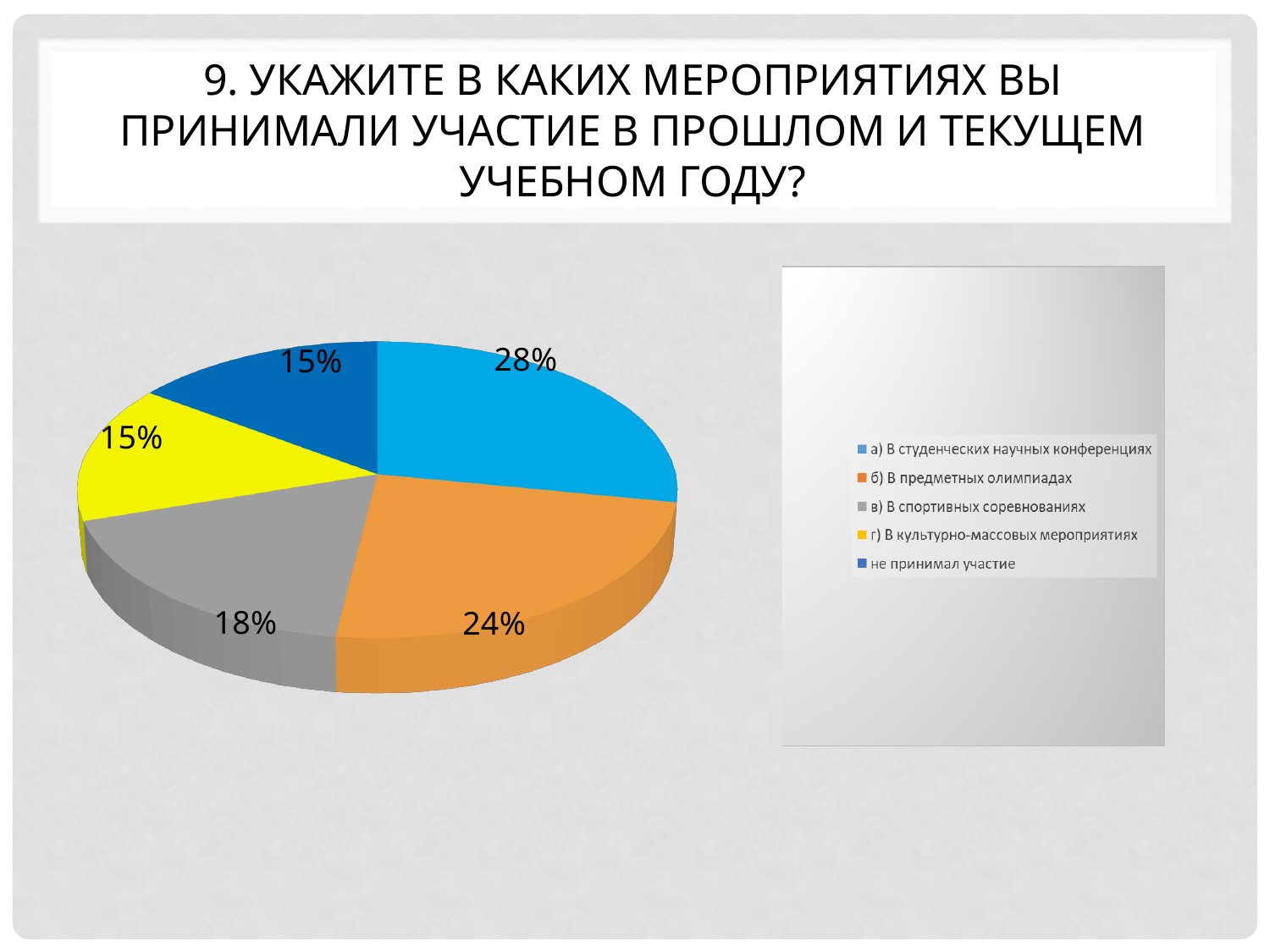
Which category has the largest slice of the pie? а) В студенческих научных конференциях What colour is the slice for "г) В культурно-массовых мероприятиях"? yellow Which is larger: the slice for "в) В спортивных соревнованиях" or the slice for "не принимал участие"? в) В спортивных соревнованиях What percentage is shown for "в) В спортивных соревнованиях"? 18% What type of chart is shown on the slide? pie chart What is the difference in percentage points between "а) В студенческих научных конференциях" and "б) В предметных олимпиадах"? 4 What percentage is shown for "г) В культурно-массовых мероприятиях"? 15% What percentage is shown for "не принимал участие"? 15% How many slices does the pie chart have? 5 How many entries does the legend list? 5 What share of the pie is labelled for "а) В студенческих научных конференциях"? 28% What percentage is shown for "б) В предметных олимпиадах"? 24%